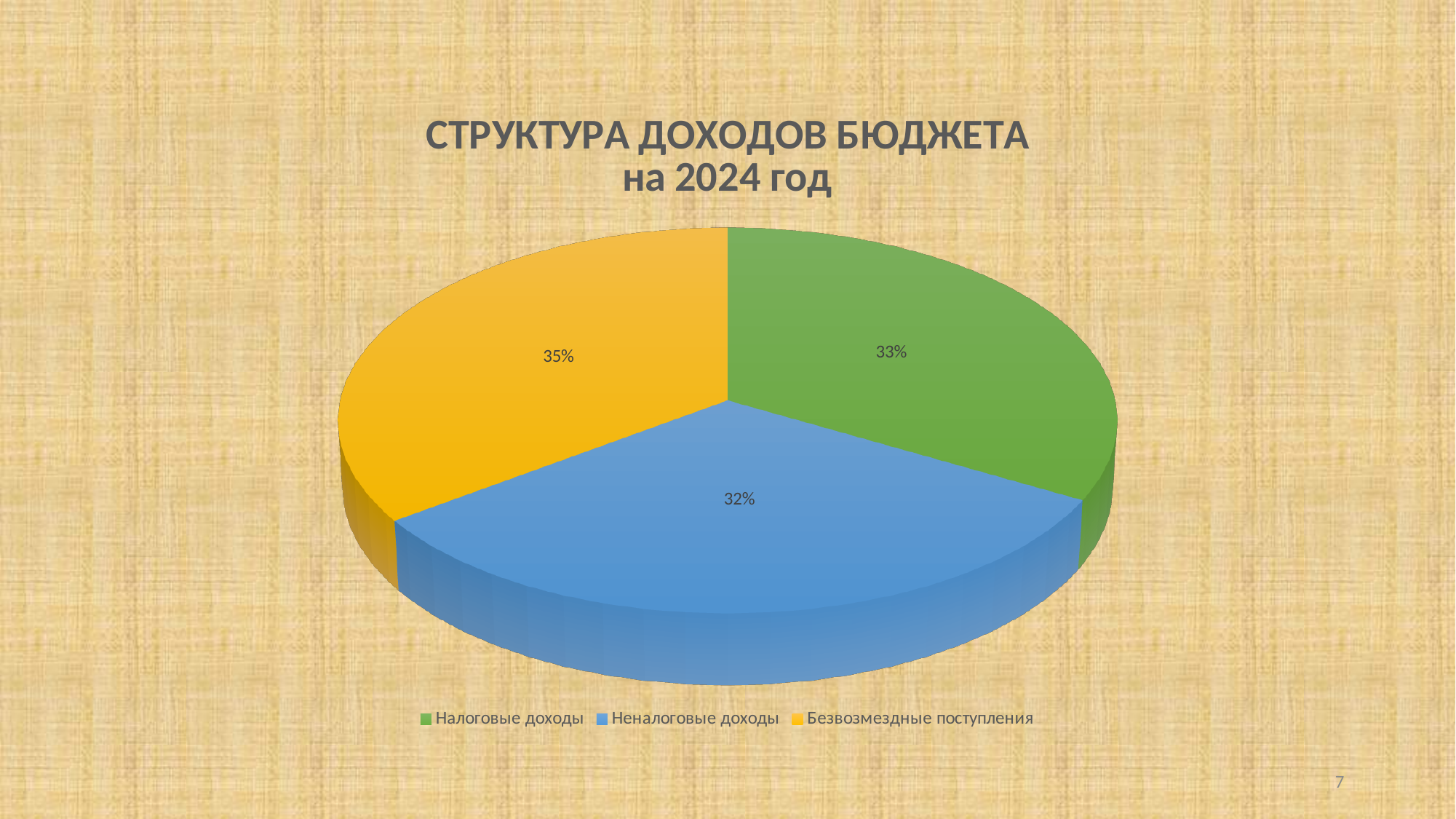
Which is larger, the share for Безвозмездные поступления or the share for Налоговые доходы? Безвозмездные поступления What is the difference in percentage points between Налоговые доходы and Неналоговые доходы? 1 What share of the pie does Налоговые доходы have? 33% What share of the pie does Неналоговые доходы have? 32% How many categories are shown in the pie chart? 3 Which category has the smallest share of the pie? Неналоговые доходы What share of the pie does Безвозмездные поступления have? 35% What is the difference in percentage points between Безвозмездные поступления and Неналоговые доходы? 3 What is the title of the chart? СТРУКТУРА ДОХОДОВ БЮДЖЕТА на 2024 год Which category has the largest share of the pie? Безвозмездные поступления What kind of chart is shown on the slide? Pie chart Which colour represents Неналоговые доходы in the legend? Blue